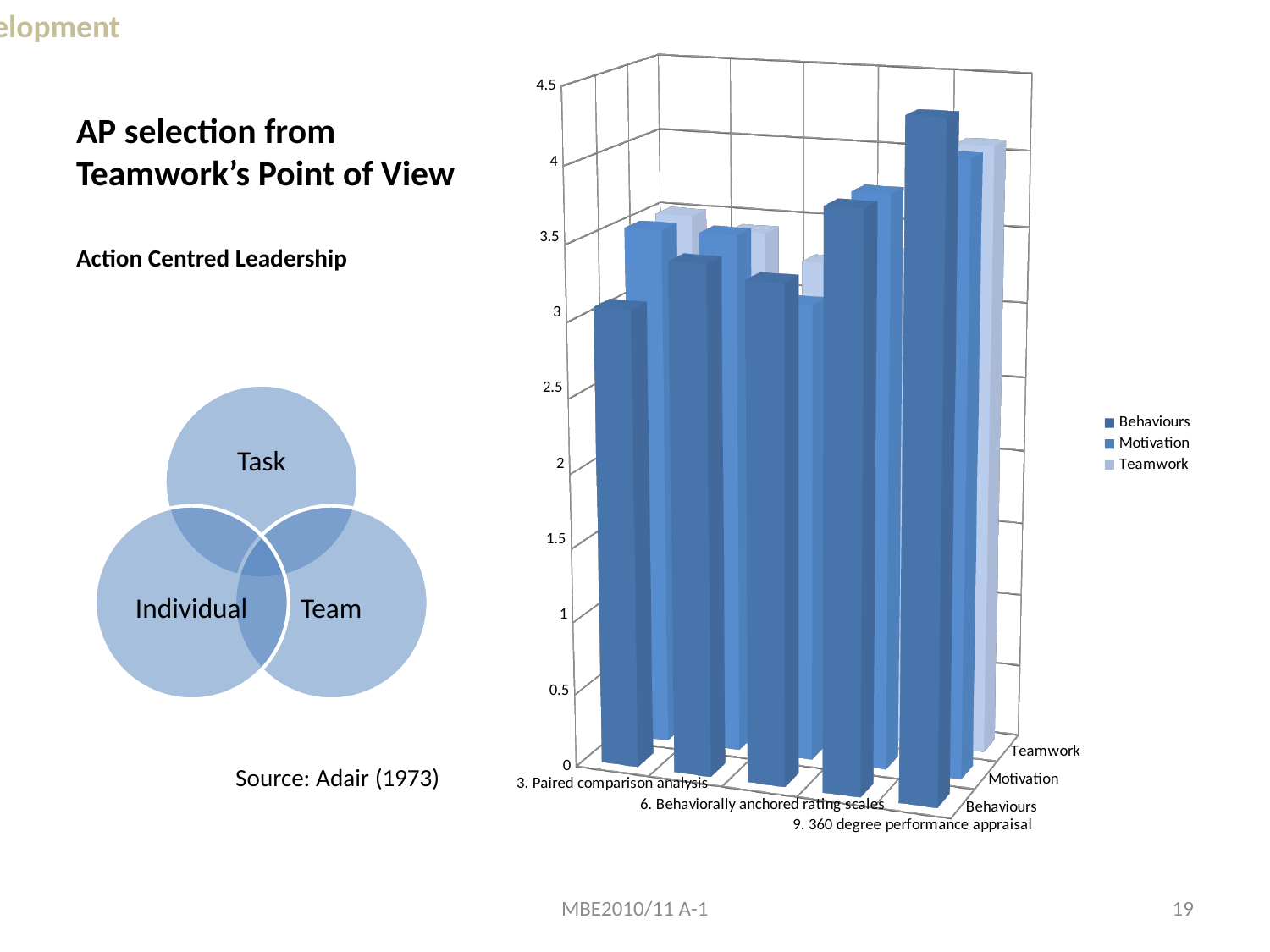
Which series is shown in the lightest blue in the chart? Teamwork Is the Behaviours value for 9. 360 degree performance appraisal greater or less than 4? greater Which is larger: the Behaviours value for 9. 360 degree performance appraisal or for 3. Paired comparison analysis? 9. 360 degree performance appraisal Is the Behaviours value for 3. Paired comparison analysis greater or less than 3.5? less Do the Behaviours values overall rise or fall from 3. Paired comparison analysis to 9. 360 degree performance appraisal? rise Which labelled category has the lowest Behaviours value? 3. Paired comparison analysis What kind of chart is shown on the right of the slide? bar chart What is the maximum value shown on the chart's vertical axis? 4.5 How many series does the chart's legend list? 3 Which labelled category has the highest Behaviours value? 9. 360 degree performance appraisal What are the three series named in the chart's legend? Behaviours, Motivation, Teamwork